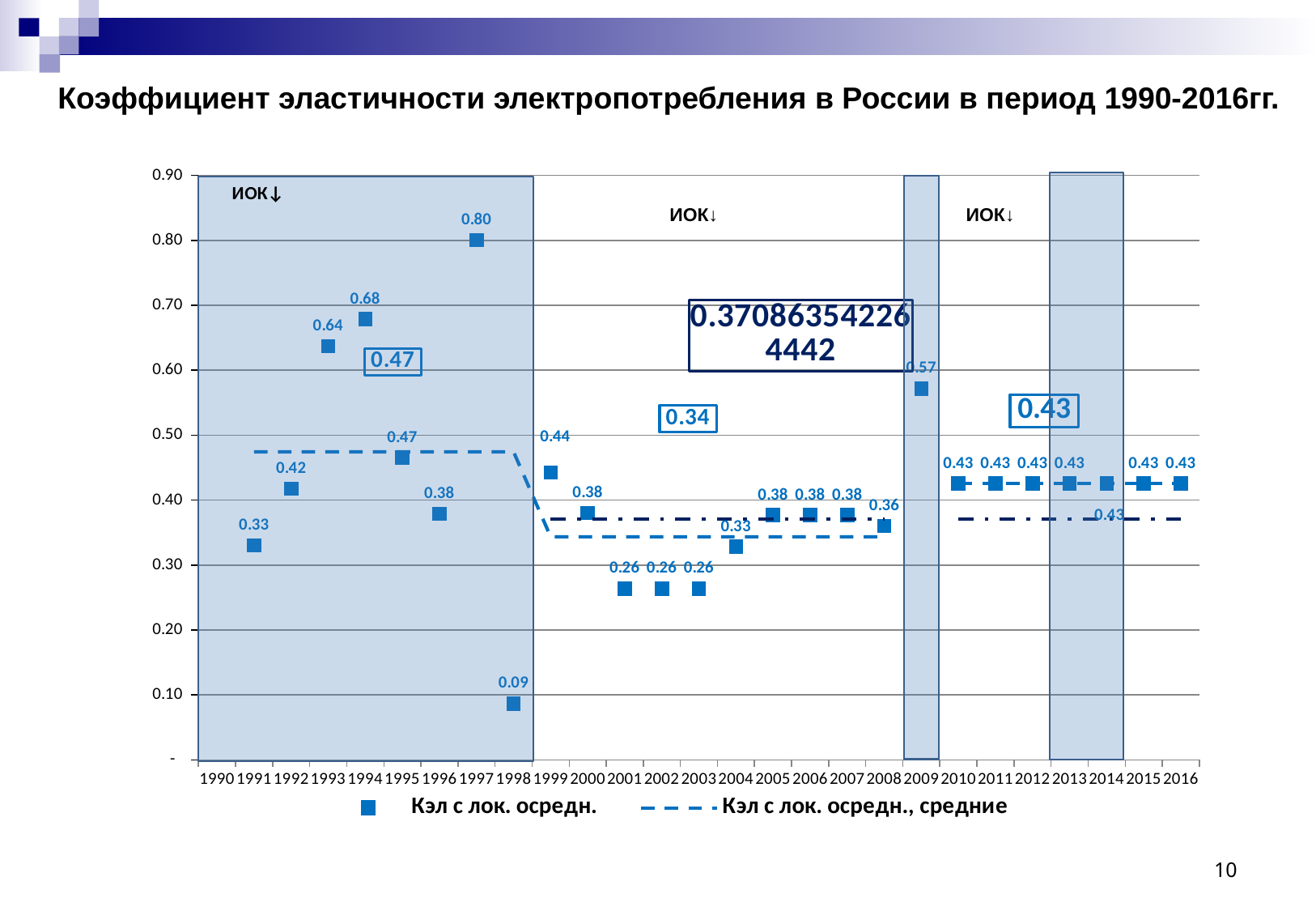
Which year has the lowest value of the 'Кэл с лок. осредн.' series? 1998 Which year has the larger value, 1993 or 1994? 1994 Which year has the highest value of the 'Кэл с лок. осредн.' series? 1997 What is the value of the 'Кэл с лок. осредн.' series for 2009? 0.57 What is the value of the 'Кэл с лок. осредн.' series for 1998? 0.09 What is the value of the 'Кэл с лок. осредн.' series for 2004? 0.33 What is the difference between the 1997 value (0.80) and the 1998 value (0.09)? 0.71 What is the difference between the 2009 value (0.57) and the 2008 value (0.36)? 0.21 What is the value of the 'Кэл с лок. осредн.' series for 1997? 0.80 Do the values of the 'Кэл с лок. осредн.' series rise or fall from 1991 to 1994? Rise What kind of chart is shown on the slide? Line chart How many series does the legend list? 2